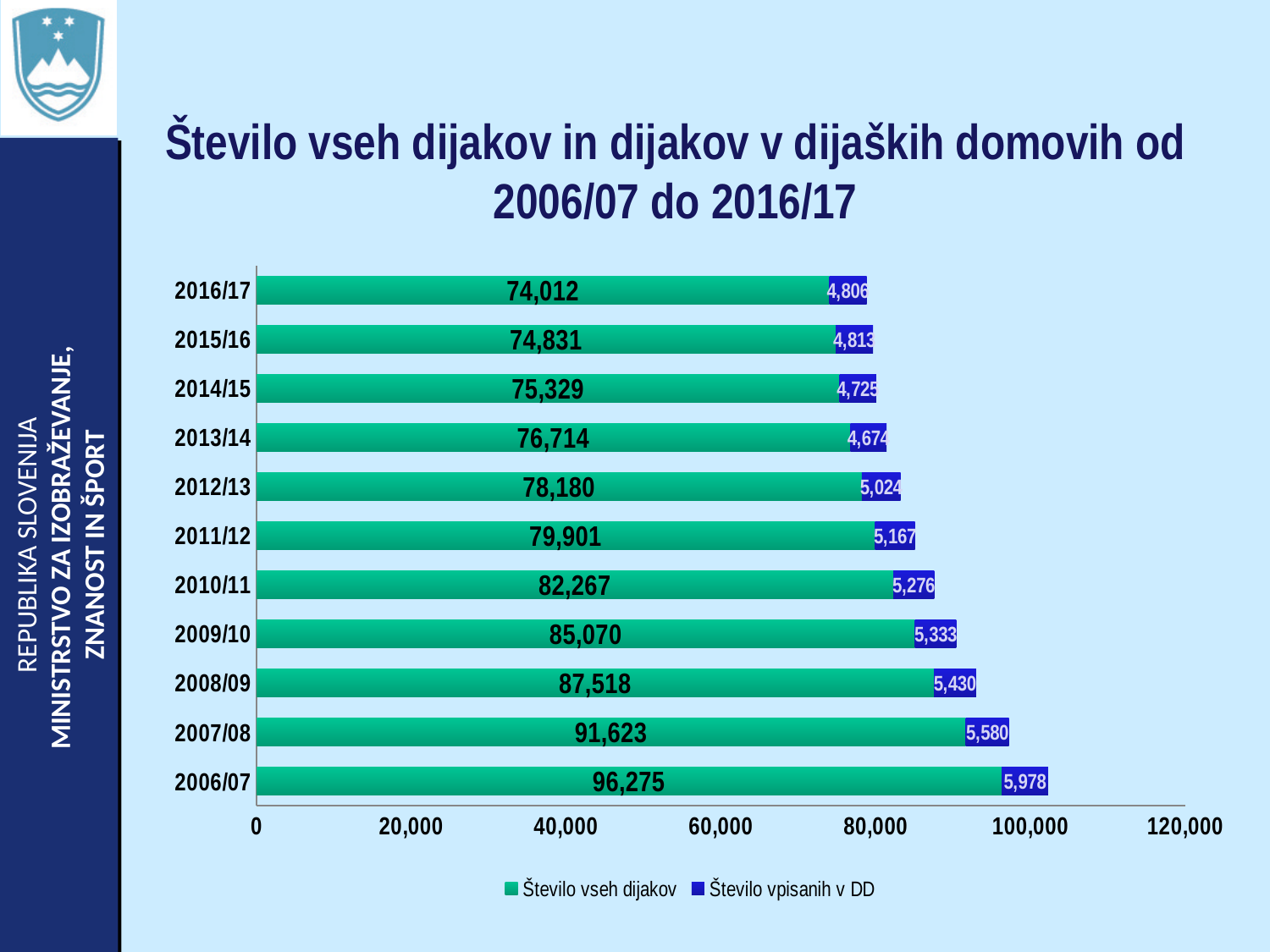
Which school year has the lowest value of Število vpisanih v DD? 2013/14 Is the value of Število vseh dijakov for 2007/08 greater or less than 80,000? greater What is the difference between Število vseh dijakov in 2006/07 and in 2016/17? 22,263 What is the value of Število vpisanih v DD for 2006/07? 5,978 What is the value of Število vseh dijakov for 2016/17? 74,012 What kind of chart is shown on the slide? bar chart Which school year has the highest value of Število vseh dijakov? 2006/07 How many school years are shown on the chart? 11 What is the total of the stacked bar for 2008/09? 92,948 What is the value of Število vseh dijakov for 2010/11? 82,267 How many series does the legend list? 2 Which is larger: Število vpisanih v DD in 2012/13 or in 2014/15? 2012/13